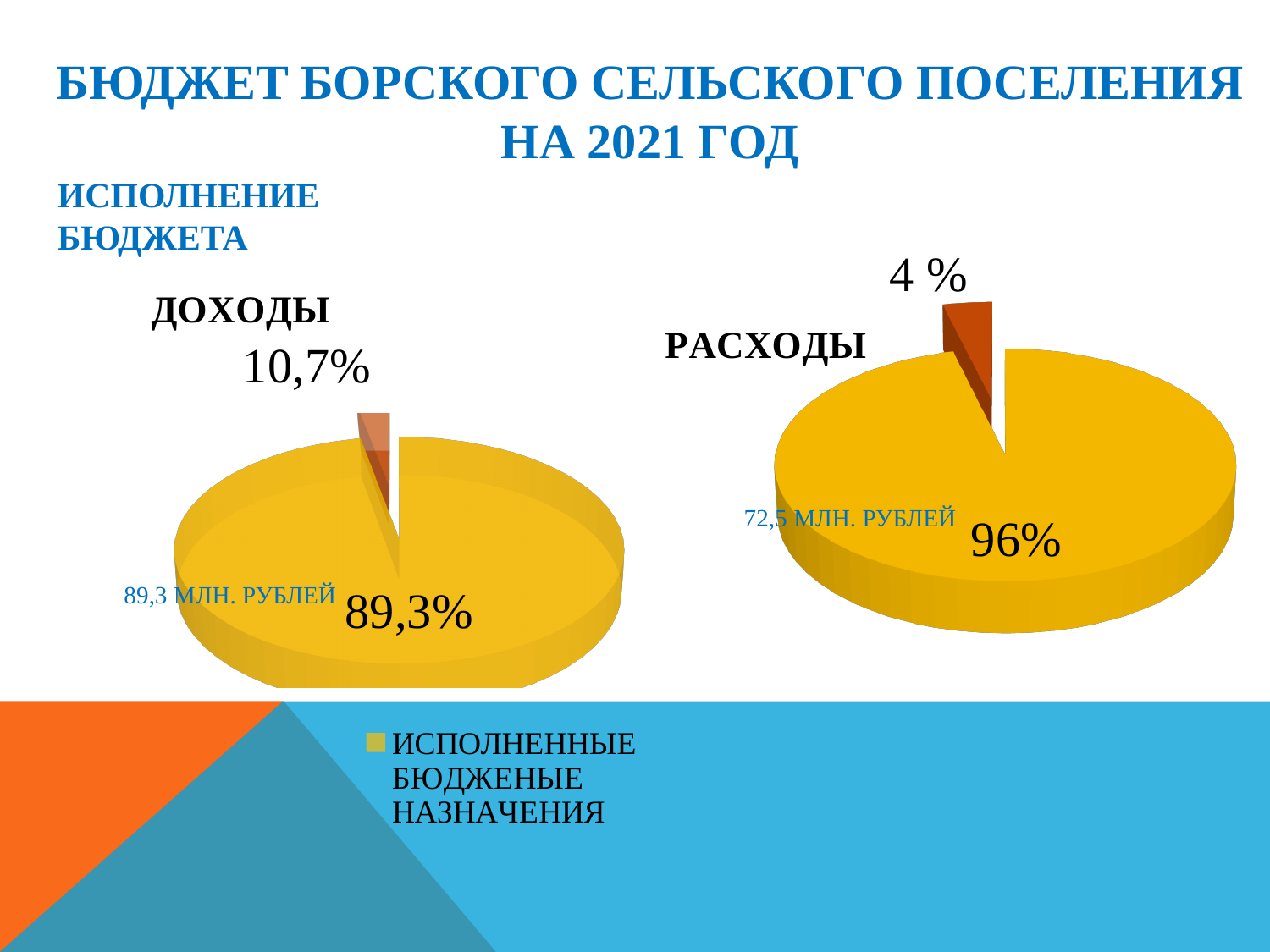
How many slices does the РАСХОДЫ pie chart have? 2 In the РАСХОДЫ chart, what share does the small orange slice represent? 4 % How many slices does the ДОХОДЫ pie chart have? 2 In the РАСХОДЫ chart, what share does the large yellow slice represent? 96% What kind of chart is the ДОХОДЫ chart on the left? pie chart In the ДОХОДЫ chart, what share does the large yellow slice represent? 89,3% In the РАСХОДЫ chart, what is the difference between the large slice and the small slice? 92% What amount in million rubles is labelled on the РАСХОДЫ chart? 72,5 МЛН. РУБЛЕЙ What kind of chart is the РАСХОДЫ chart on the right? pie chart Which chart has the larger yellow slice share, ДОХОДЫ or РАСХОДЫ? РАСХОДЫ In the ДОХОДЫ chart, what is the difference between the large slice and the small slice? 78,6%